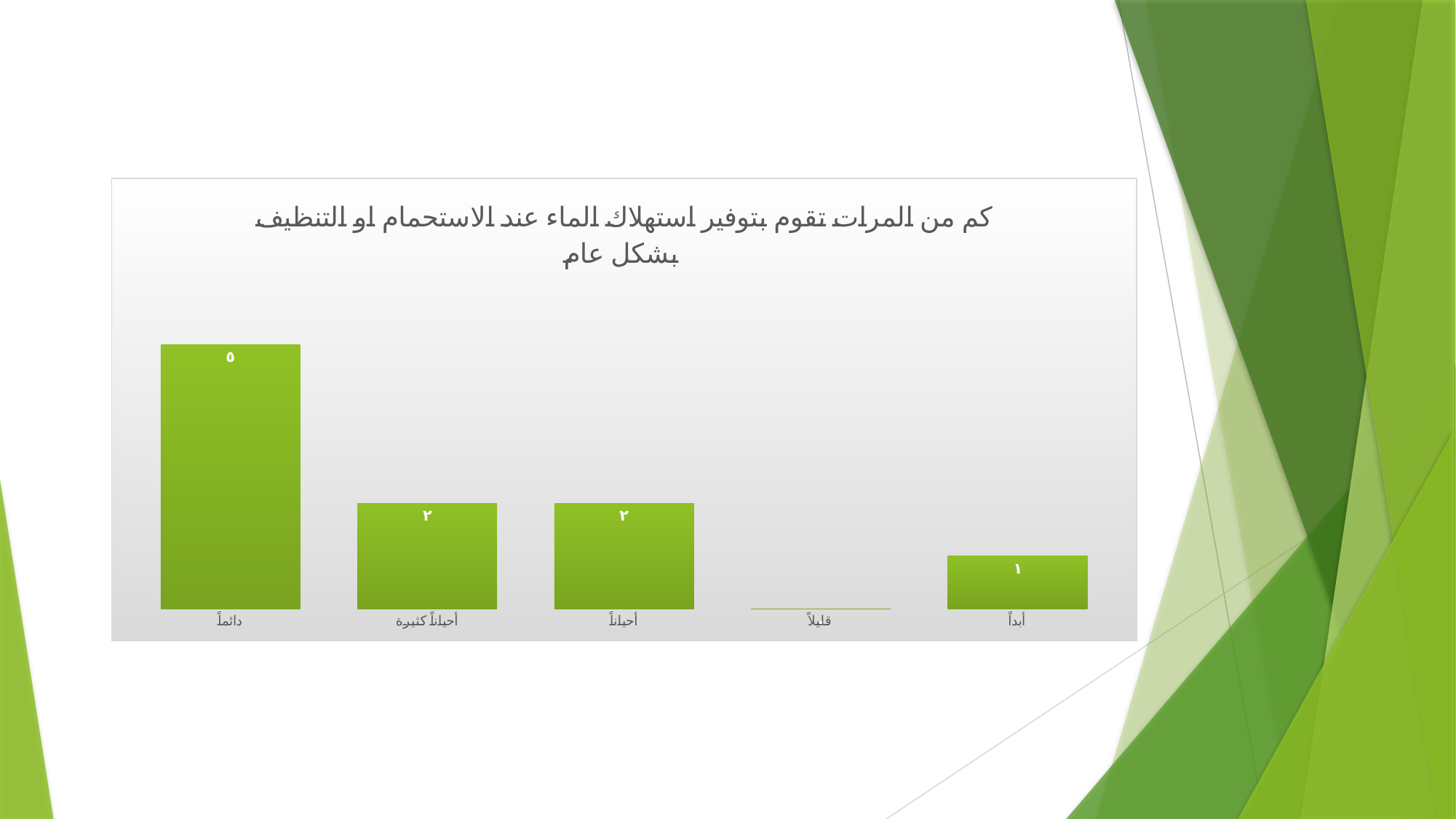
What is the difference between the values for دائماً and أبداً? ٤ What is the difference between the values for دائماً and أحياناً كثيرة? ٣ What is the value for أبداً? ١ How many categories are shown on the x axis? 5 What is the value for دائماً? ٥ What kind of chart is shown on the slide? Bar chart Which category has the lowest value? قليلاً Which category has the highest value? دائماً What is the value for أحياناً كثيرة? ٢ What is the value for أحياناً? ٢ What colour are the bars in the chart? Green Which is larger, the value for أحياناً or the value for أبداً? أحياناً